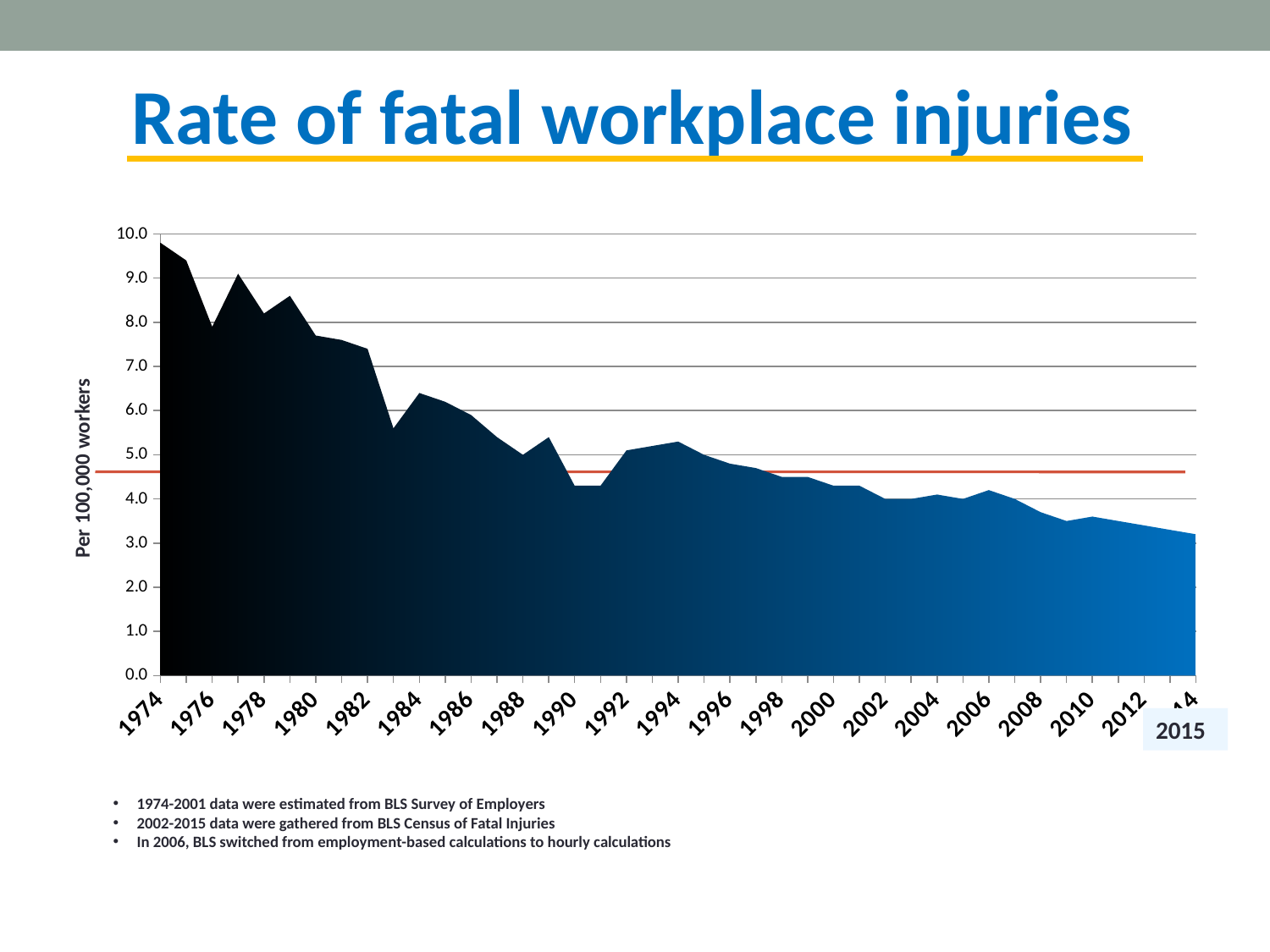
Is the value for 2015 greater or less than 4.0? less Which year has the lowest rate of fatal workplace injuries? 2015 Overall, do the values rise or fall from 1974 to 2015? fall Is the value for 1974 greater or less than 9.0? greater What is the title of the slide? Rate of fatal workplace injuries Is the value for 1990 greater or less than 5.0? less Which year has the larger value, 1974 or 2015? 1974 What is the label on the vertical axis? Per 100,000 workers Which year has the highest rate of fatal workplace injuries? 1974 What kind of chart is shown on the slide? area chart